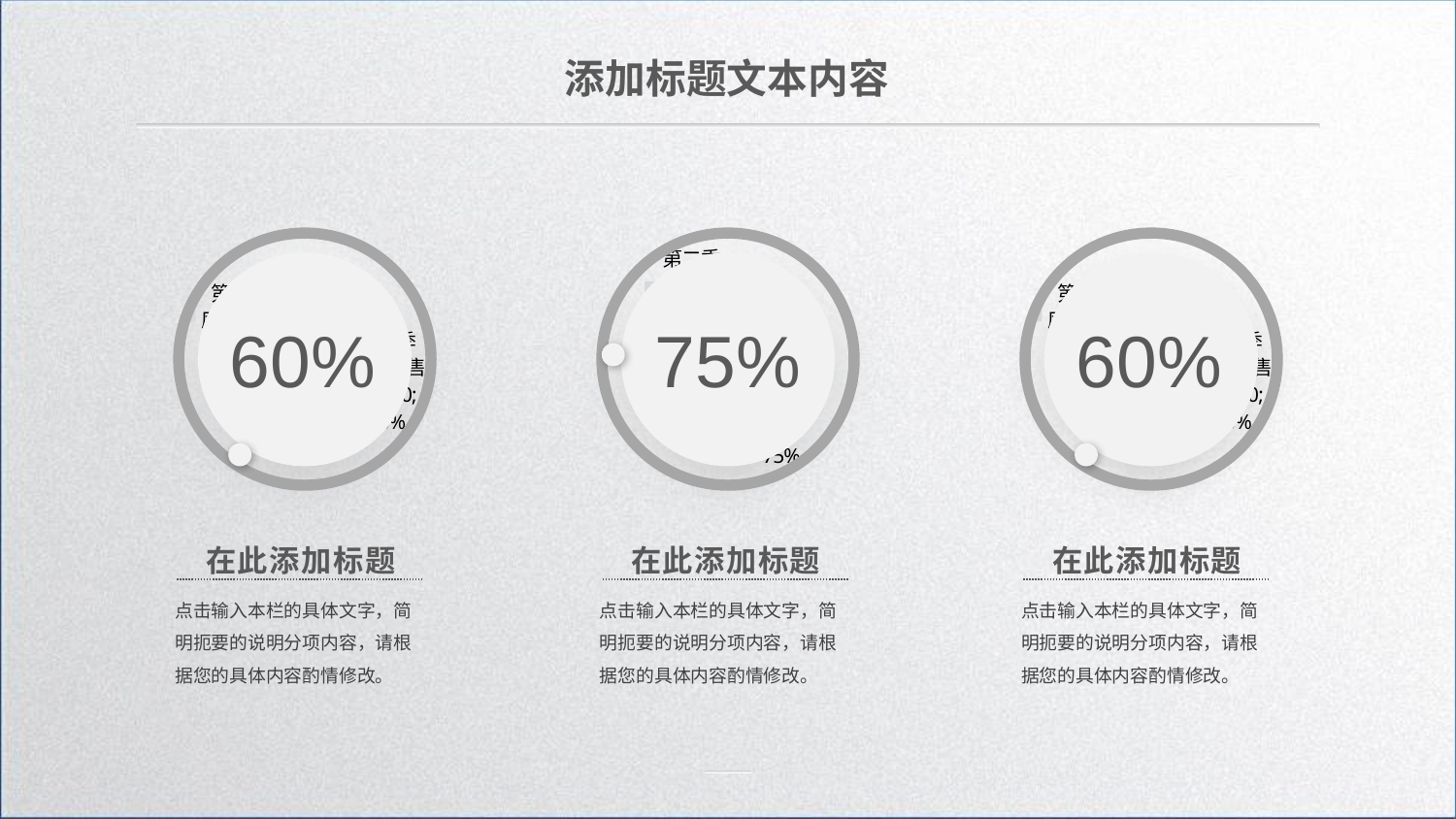
What percentage is shown in the centre of the left circular chart? 60% Do the left and right circular charts show the same percentage? Yes, both show 60% What is the title text at the top of the slide? 添加标题文本内容 How many circular charts are shown on the slide? 3 Is the value shown in the middle circular chart greater or less than 50%? greater Which of the three circular charts shows the highest percentage? The middle chart (75%) What percentage is shown in the centre of the right circular chart? 60% What kind of chart is used for each of the three figures on the slide? Doughnut (ring) chart What is the difference between the percentage in the middle circular chart and the percentage in the right circular chart? 15% Is the percentage in the middle circular chart larger or smaller than the percentage in the left circular chart? Larger What percentage is shown in the centre of the middle circular chart? 75% What heading appears below each circular chart? 在此添加标题